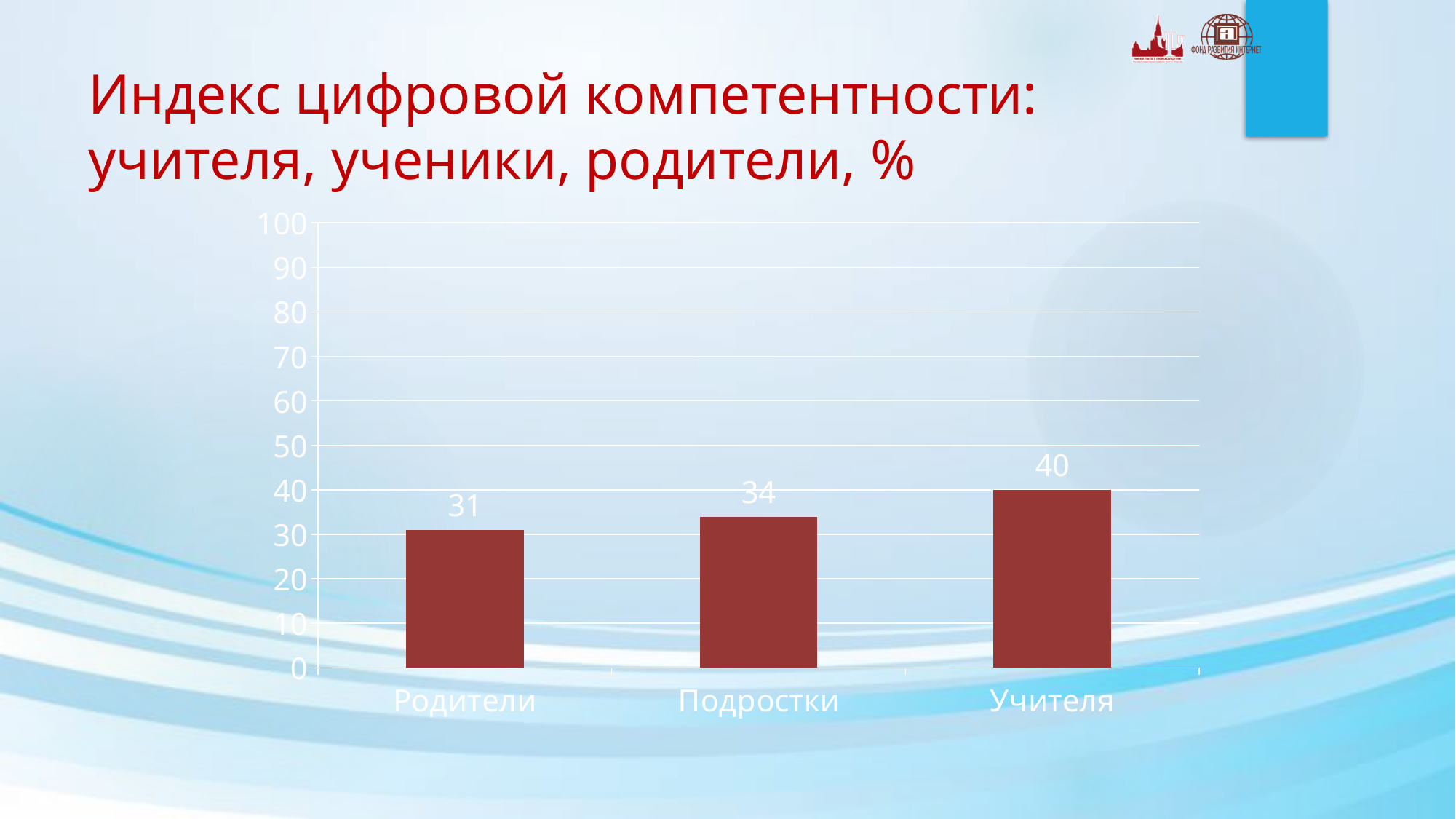
What is the difference between the values for Учителя and Родители? 9 Do the values rise or fall from left to right along the x axis? rise Which category has the lowest value? Родители What kind of chart is shown on the slide? bar chart What is the value for Родители? 31 Is the value for Учителя greater or less than 50? less What is the value for Подростки? 34 What is the value for Учителя? 40 Which category has the highest value? Учителя Which is larger, the value for Подростки or the value for Учителя? Учителя What is the difference between the values for Подростки and Родители? 3 How many categories are shown on the x axis? 3